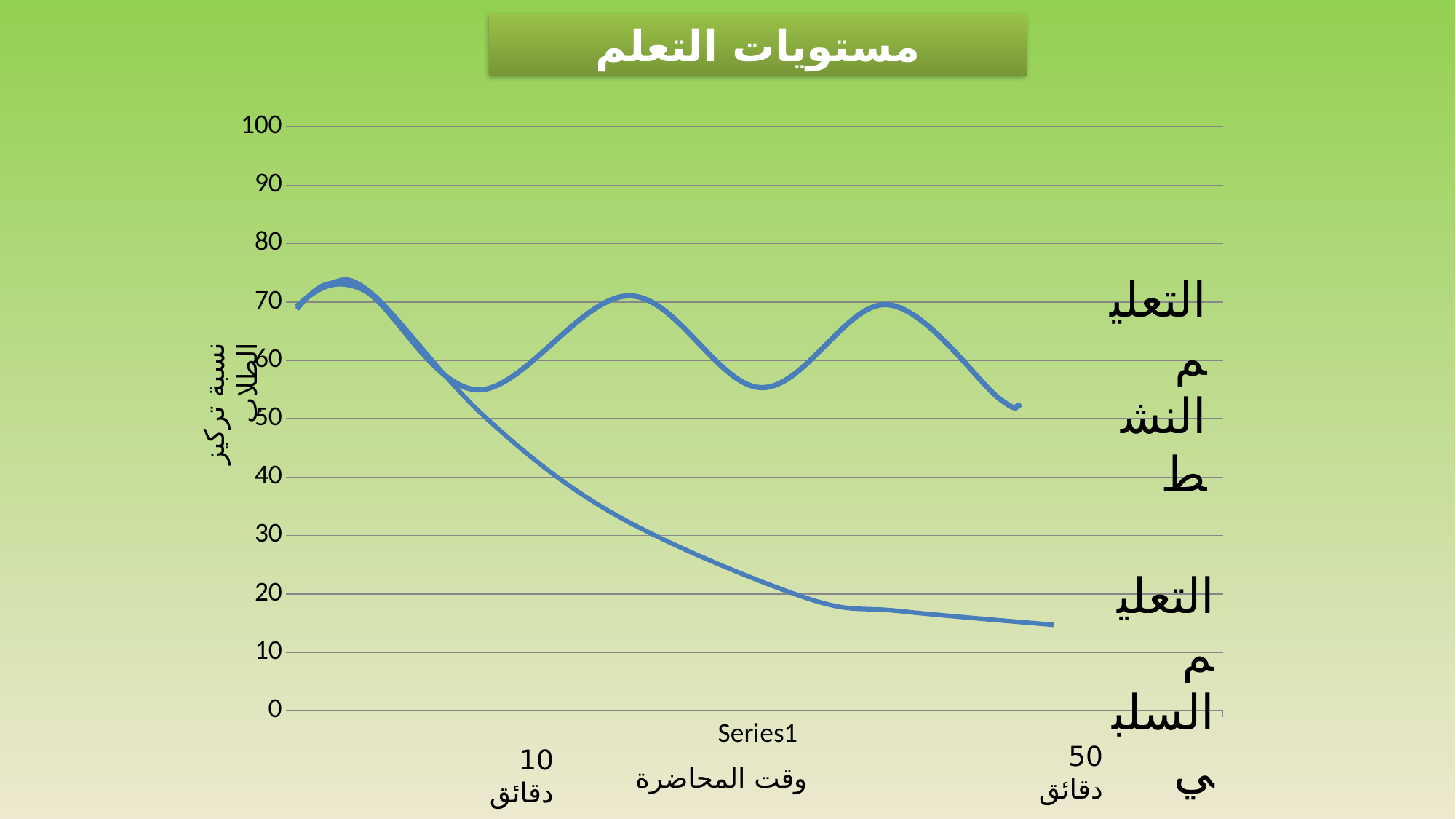
How many lines are plotted on the chart? 2 At the right end of the chart, which line is higher, التعليم النشط or التعليم السلبي? التعليم النشط Is the lowest point of the التعليم النشط line greater or less than 40? greater Does the line for التعليم السلبي rise or fall overall along the x axis? fall What is the maximum value shown on the vertical axis? 100 What is the title of the chart? مستويات التعلم At the right end of the chart, is the value of the التعليم النشط line greater or less than 40? greater At the right end of the chart, is the value of the التعليم السلبي line greater or less than 20? less What is the label on the vertical axis of the chart? نسبة تركيز الطلاب What kind of chart is shown on the slide? line chart